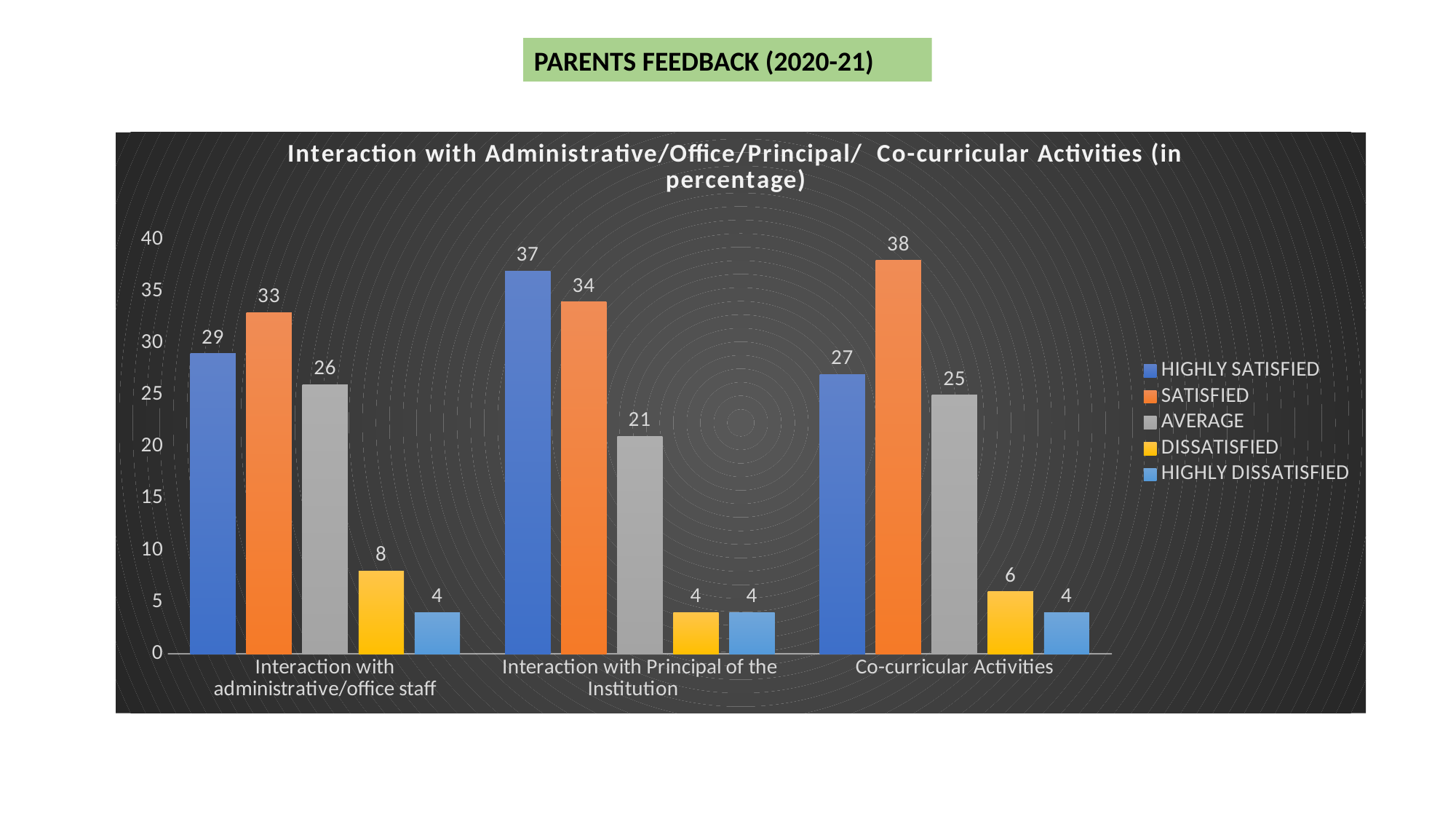
What kind of chart is shown on the slide? Bar chart Which is larger for Interaction with administrative/office staff: HIGHLY SATISFIED or SATISFIED? SATISFIED What is the AVERAGE value for Interaction with Principal of the Institution? 21 Which colour represents the AVERAGE series? Grey How many categories are shown on the x axis? 3 Which category has the lowest DISSATISFIED value? Interaction with Principal of the Institution What is the DISSATISFIED value for Interaction with administrative/office staff? 8 What is the SATISFIED value for Co-curricular Activities? 38 Which category has the highest HIGHLY SATISFIED value? Interaction with Principal of the Institution How many series does the legend list? 5 What is the difference between the SATISFIED and HIGHLY SATISFIED values for Co-curricular Activities? 11 What is the HIGHLY SATISFIED value for Interaction with administrative/office staff? 29